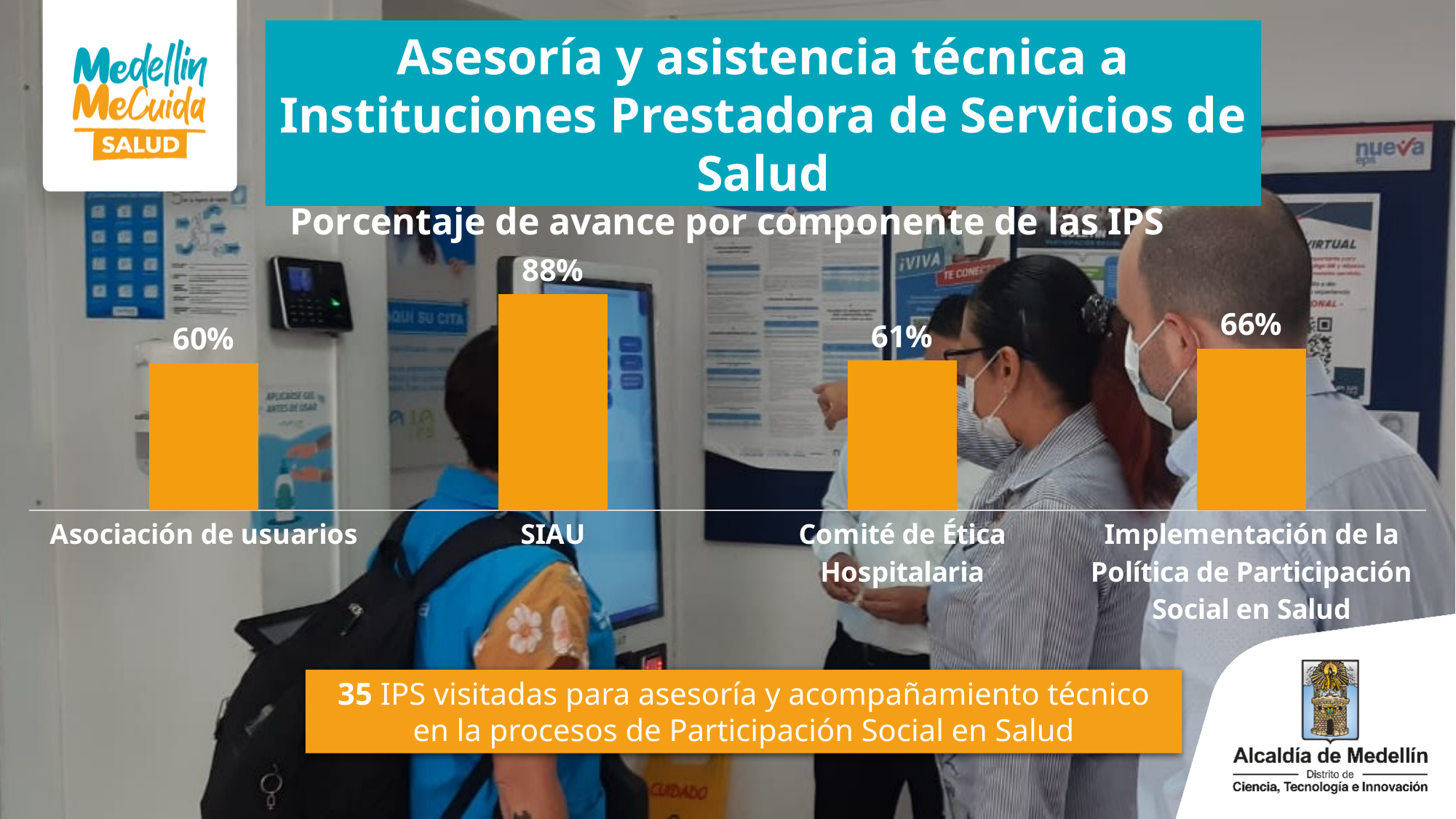
Which is larger, the value for SIAU or the value for Implementación de la Política de Participación Social en Salud? SIAU How many components are shown in the chart? 4 What is the value for SIAU? 88% What is the difference between the values for Implementación de la Política de Participación Social en Salud and Comité de Ética Hospitalaria? 5% What kind of chart is shown on the slide? Bar chart What is the title of the chart? Porcentaje de avance por componente de las IPS What is the value for Comité de Ética Hospitalaria? 61% What is the value for Asociación de usuarios? 60% Which component has the lowest percentage of progress? Asociación de usuarios What is the difference between the values for SIAU and Asociación de usuarios? 28% What is the value for Implementación de la Política de Participación Social en Salud? 66% Which component has the highest percentage of progress? SIAU